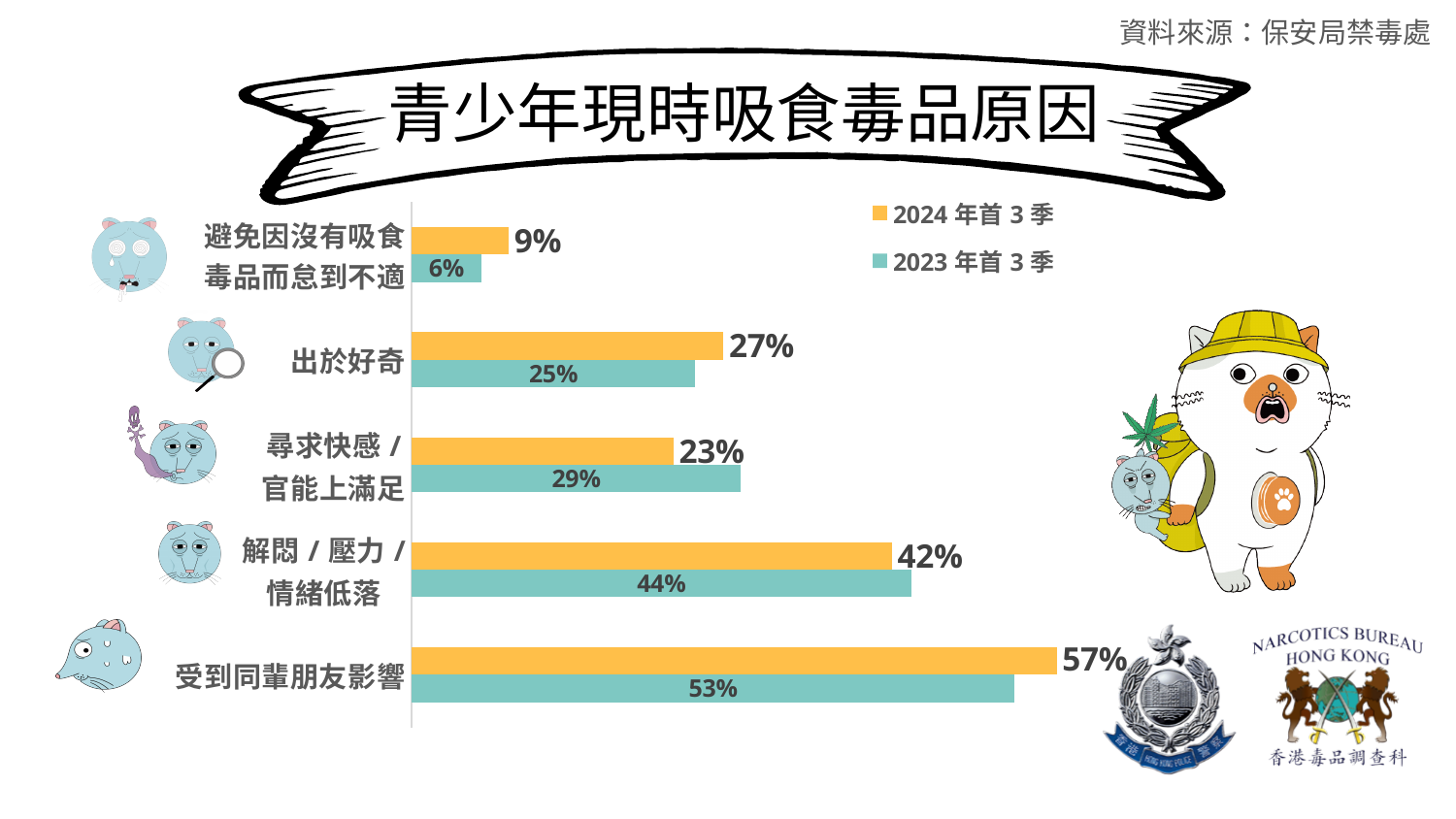
Which category has the highest value in the 2024 年首 3 季 series? 受到同輩朋友影響 What is the value for 尋求快感 / 官能上滿足 in the 2023 年首 3 季 series? 29% How many categories are shown in the chart? 5 What is the value for 避免因沒有吸食毒品而怠到不適 in the 2024 年首 3 季 series? 9% How many series does the legend list? 2 What is the title of the chart? 青少年現時吸食毒品原因 What kind of chart is shown on the slide? Bar chart Which category has the lowest value in the 2023 年首 3 季 series? 避免因沒有吸食毒品而怠到不適 What is the value for 受到同輩朋友影響 in the 2024 年首 3 季 series? 57% What is the difference between the 2024 年首 3 季 and 2023 年首 3 季 values for 受到同輩朋友影響? 4% For 尋求快感 / 官能上滿足, which series has the larger value, 2024 年首 3 季 or 2023 年首 3 季? 2023 年首 3 季 For 出於好奇, which series has the larger value, 2024 年首 3 季 or 2023 年首 3 季? 2024 年首 3 季